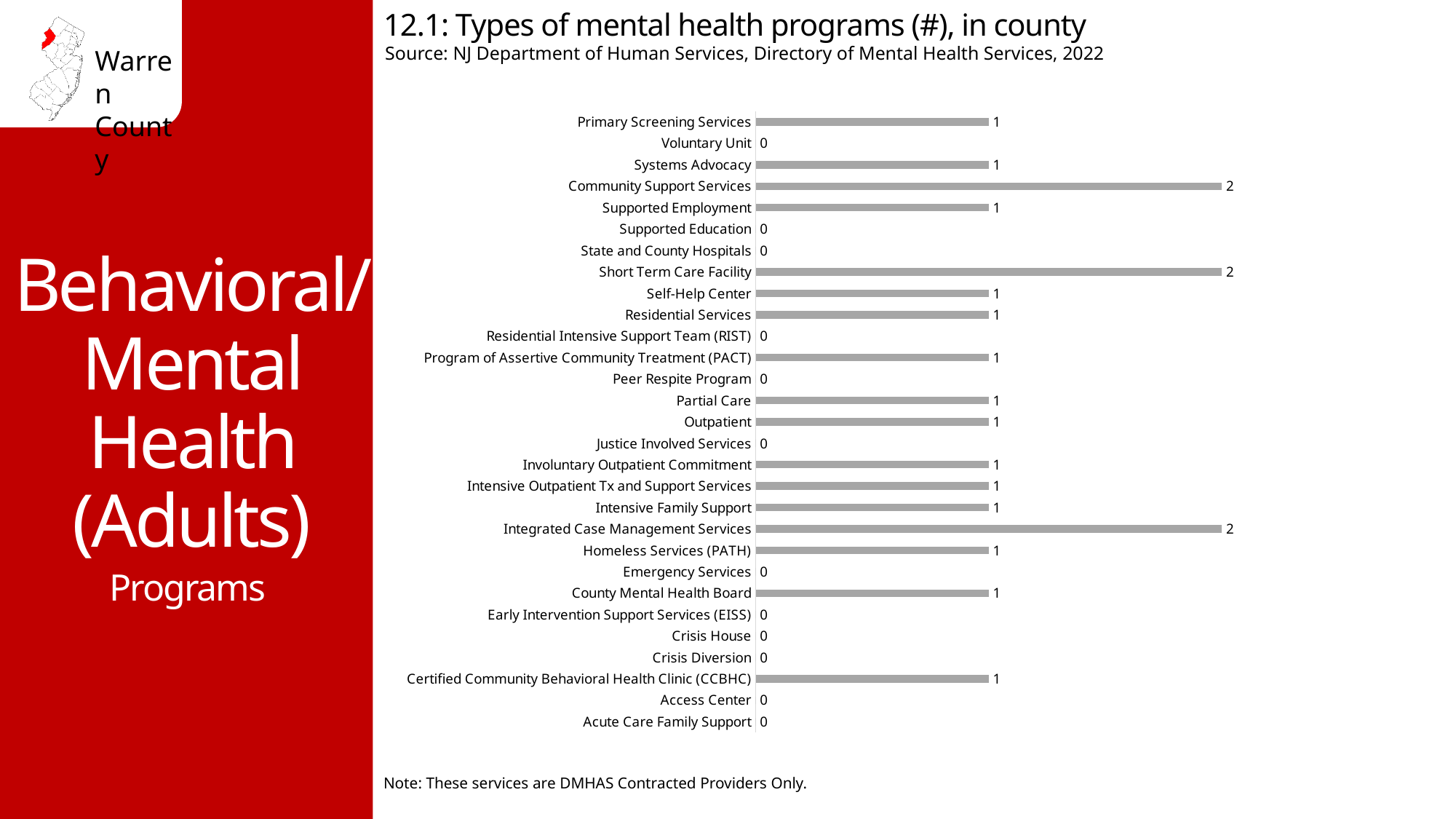
How many categories have a value of 2? 3 What is the value for Community Support Services? 2 What is the value for Crisis House? 0 What is the difference between the values for Short Term Care Facility and Self-Help Center? 1 Which is larger, the value for Integrated Case Management Services or the value for Homeless Services (PATH)? Integrated Case Management Services What is the value for Voluntary Unit? 0 What kind of chart is shown on the slide? Bar chart How many categories are shown on the chart? 29 What is the title of the chart? 12.1: Types of mental health programs (#), in county Which categories have the highest value on the chart? Community Support Services, Short Term Care Facility, Integrated Case Management Services What is the value for Program of Assertive Community Treatment (PACT)? 1 What is the value for Certified Community Behavioral Health Clinic (CCBHC)? 1